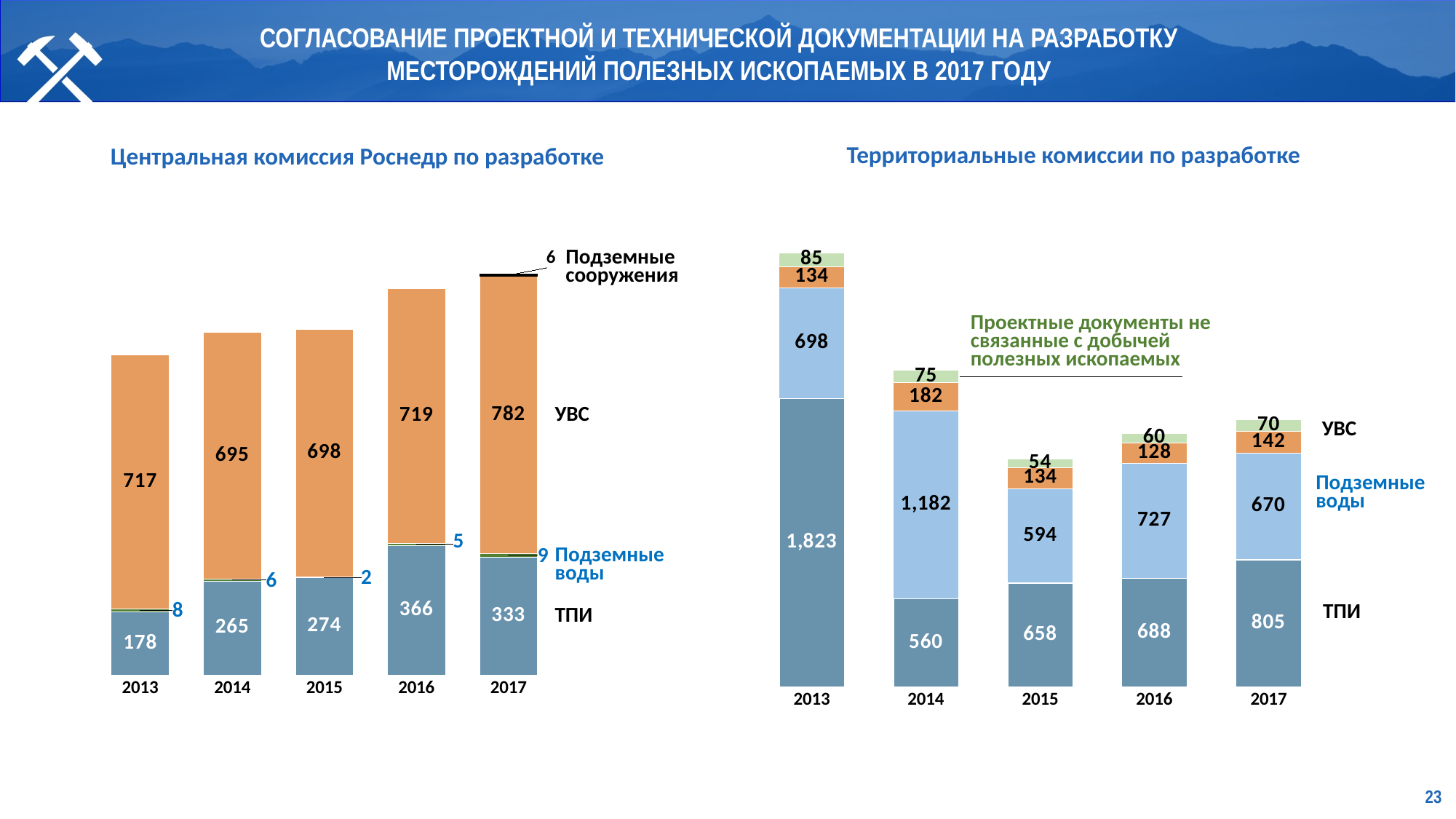
In the chart 'Центральная комиссия Роснедр по разработке', what is the total of the stacked bar for 2017? 1130 In the chart 'Территориальные комиссии по разработке', what is the value for Подземные воды in 2014? 1,182 What type of chart is used on the slide? Stacked bar chart In the chart 'Территориальные комиссии по разработке', what is the difference between the УВС values for 2014 and 2015? 48 In the chart 'Территориальные комиссии по разработке', what is the total of the stacked bar for 2013? 2,740 In the chart 'Центральная комиссия Роснедр по разработке', how many years are shown on the x axis? 5 In the chart 'Центральная комиссия Роснедр по разработке', what is the value for УВС in 2017? 782 In the chart 'Центральная комиссия Роснедр по разработке', what is the difference between the УВС values for 2017 and 2016? 63 In the chart 'Территориальные комиссии по разработке', which year has the lowest ТПИ value? 2014 In the chart 'Центральная комиссия Роснедр по разработке', which year has the highest ТПИ value? 2016 In the chart 'Территориальные комиссии по разработке', which is larger in 2016: ТПИ or Подземные воды? Подземные воды In the chart 'Центральная комиссия Роснедр по разработке', what is the value for ТПИ in 2013? 178